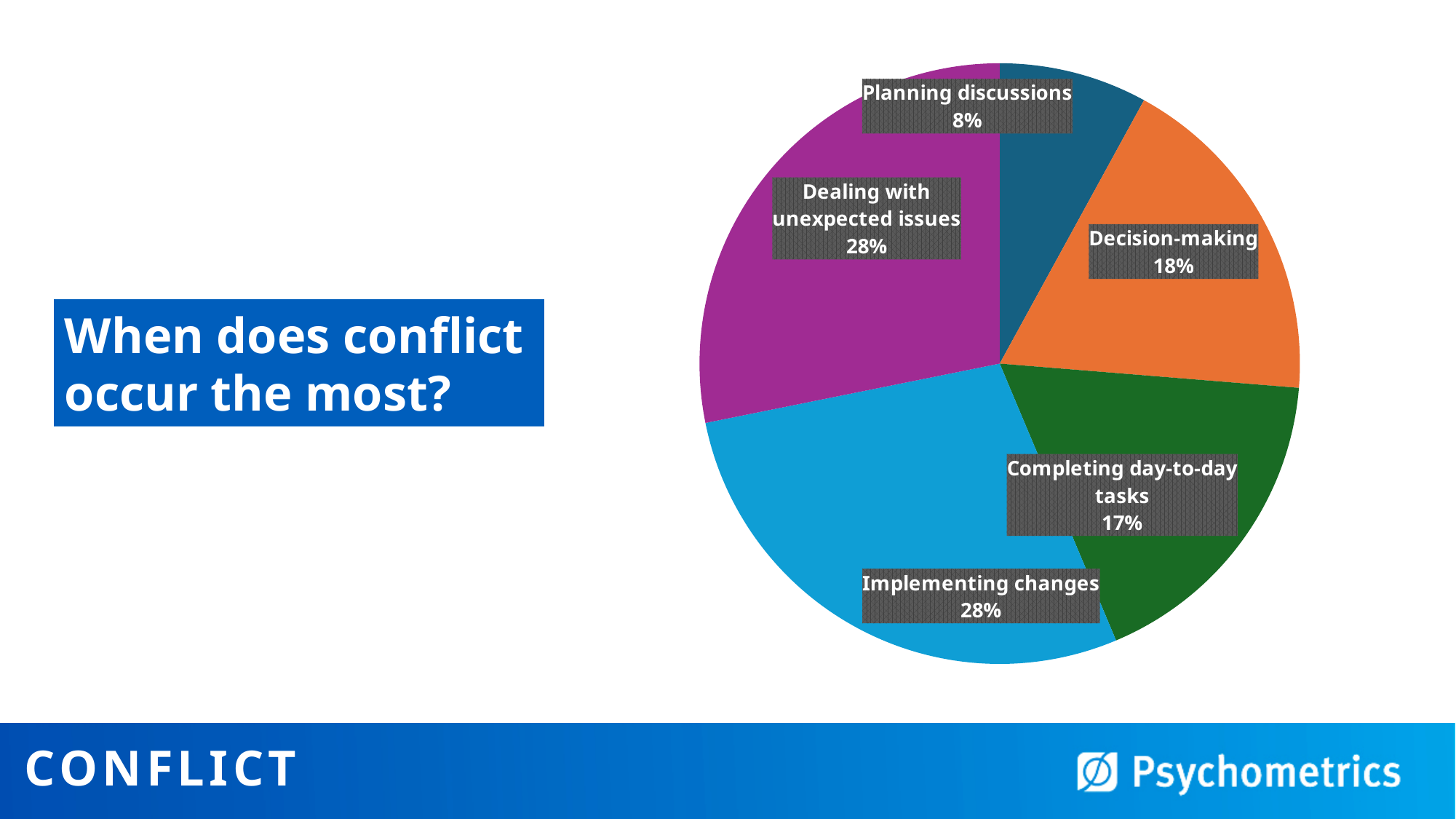
Which is larger, Decision-making or Planning discussions? Decision-making Which category has the smallest slice of the pie? Planning discussions How many categories are shown in the pie chart? 5 Which is larger, Implementing changes or Completing day-to-day tasks? Implementing changes What percentage is shown for Decision-making? 18% What share of the pie does Dealing with unexpected issues take? 28% What value is shown for Completing day-to-day tasks? 17% What percentage of the pie is Planning discussions? 8% What kind of chart is shown on the slide? Pie chart What is the difference in percentage points between Decision-making and Completing day-to-day tasks? 1 What is the difference in percentage points between Implementing changes and Planning discussions? 20 What share of the pie does Implementing changes take? 28%